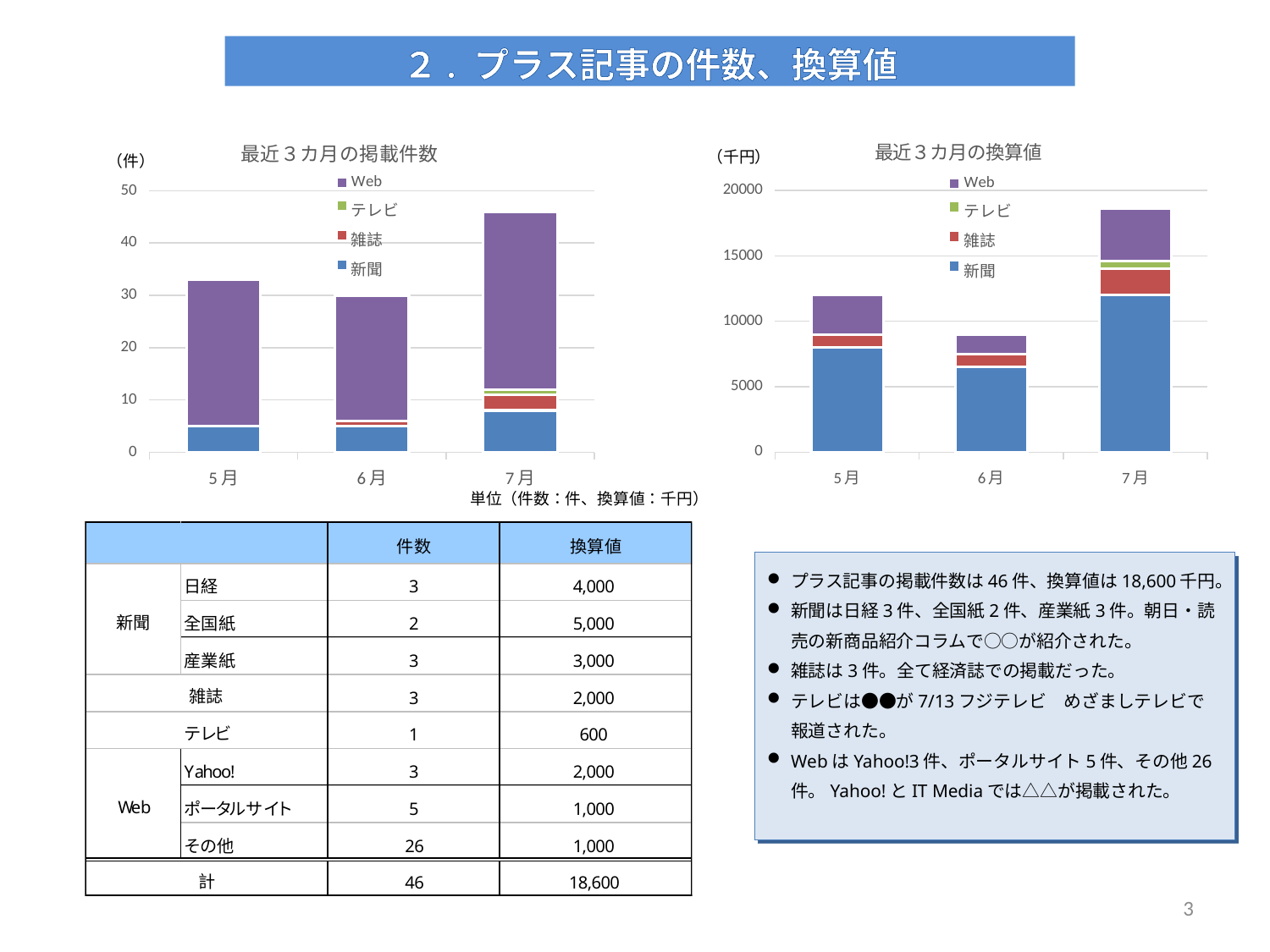
In the left chart titled 最近３カ月の掲載件数, is the total for 7月 greater or less than 40? greater In the left chart titled 最近３カ月の掲載件数, which month has the tallest stacked bar? 7月 What unit label is shown at the top of the vertical axis of the right chart titled 最近３カ月の換算値? (千円) How many months are shown on the x axis of the right chart titled 最近３カ月の換算値? 3 In the right chart titled 最近３カ月の換算値, is the total for 6月 greater or less than 10000? less In the left chart titled 最近３カ月の掲載件数, is the total for 6月 greater or less than 40? less What kind of chart is the left chart titled 最近３カ月の掲載件数? stacked bar chart In the right chart titled 最近３カ月の換算値, which month has the tallest stacked bar? 7月 How many series does the legend of the left chart titled 最近３カ月の掲載件数 list? 4 In the right chart titled 最近３カ月の換算値, which month has the larger total, 5月 or 6月? 5月 In the right chart titled 最近３カ月の換算値, which month has the shortest stacked bar? 6月